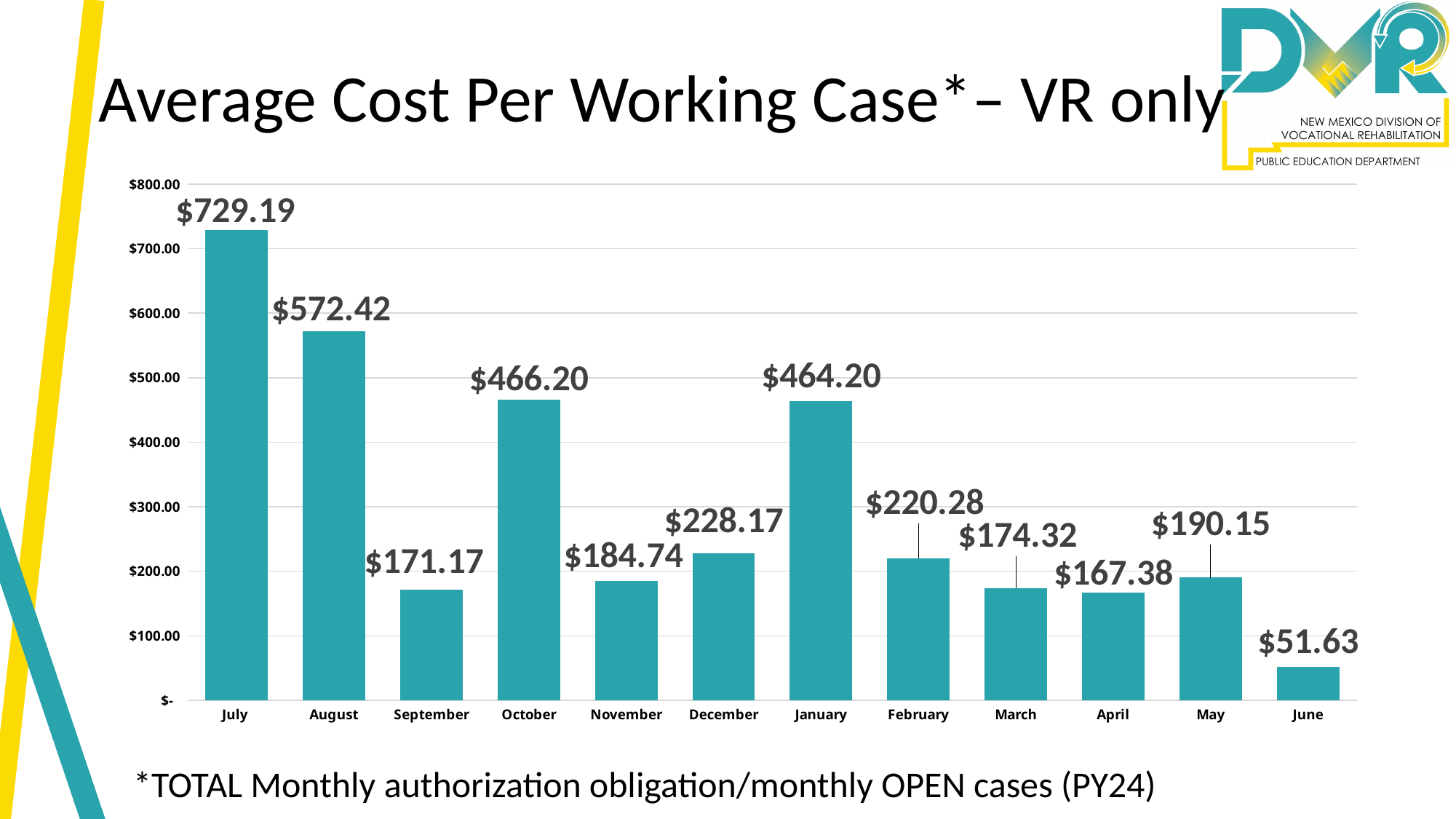
What is the average cost per working case for January? $464.20 What kind of chart is shown on the slide? Bar chart What is the average cost per working case for July? $729.19 How many months are shown on the chart? 12 What is the title of the slide? Average Cost Per Working Case* – VR only Is the value for December greater or less than $200.00? greater What is the difference between the average cost for July and August? $156.77 Which month has a higher average cost per working case, October or January? October Does the average cost per working case rise or fall from July to September? Fall Which month has the lowest average cost per working case? June What is the average cost per working case for June? $51.63 Which month has the highest average cost per working case? July